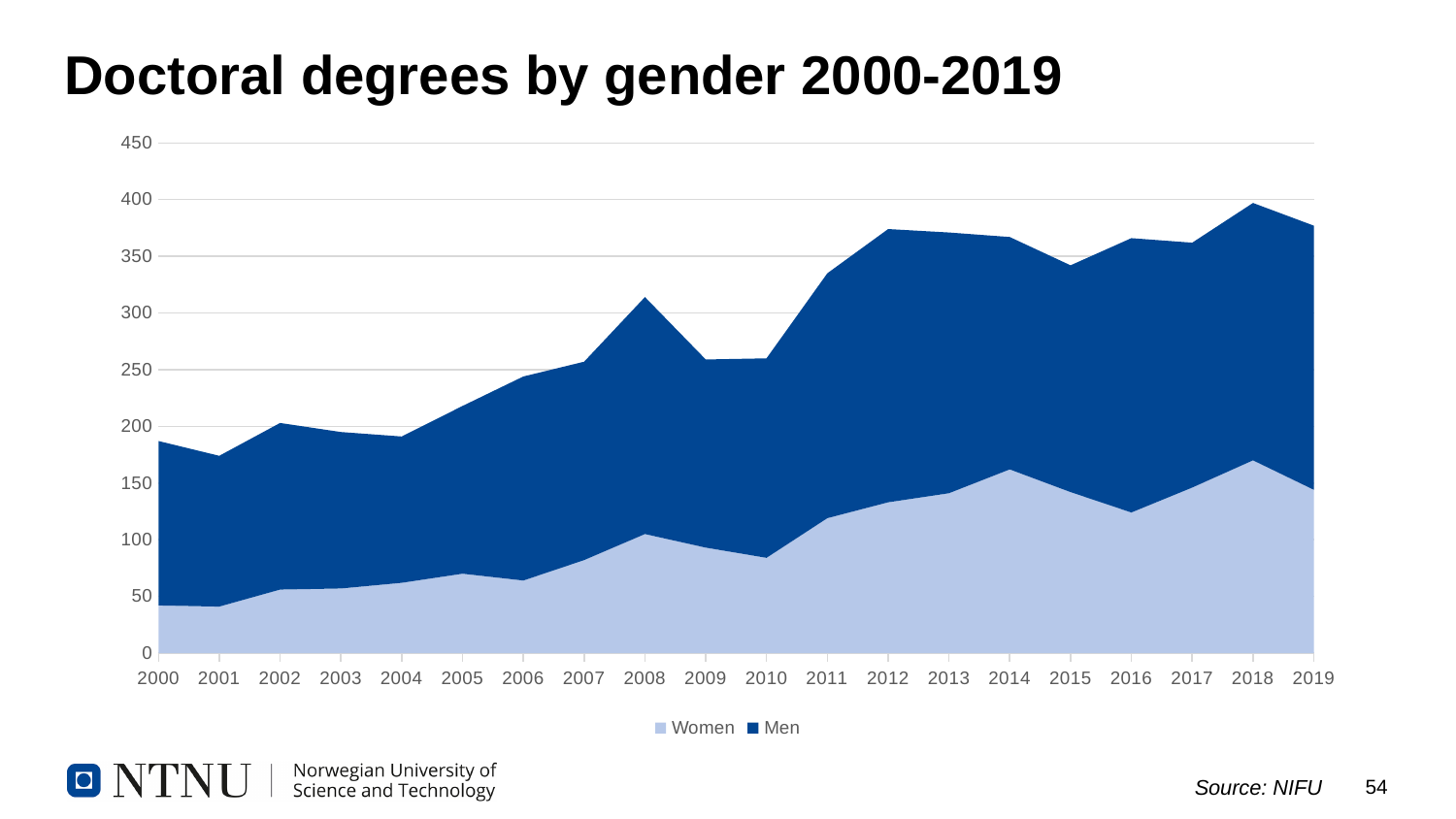
How many years are shown along the x axis? 20 Does the total number of doctoral degrees generally rise or fall from 2000 to 2019? rise What kind of chart is shown on the slide? Stacked area chart Is the total number of doctoral degrees (Women plus Men) in 2001 greater or less than 200? less How many series does the legend list? 2 Is the total number of doctoral degrees (Women plus Men) in 2018 greater or less than 350? greater Is the value for Women in 2018 greater or less than 150? greater In which year is the value for Women highest? 2018 In which year is the total number of doctoral degrees (top of the stacked area) highest? 2018 Which year has the larger total number of doctoral degrees, 2001 or 2012? 2012 What are the two series named in the legend? Women and Men